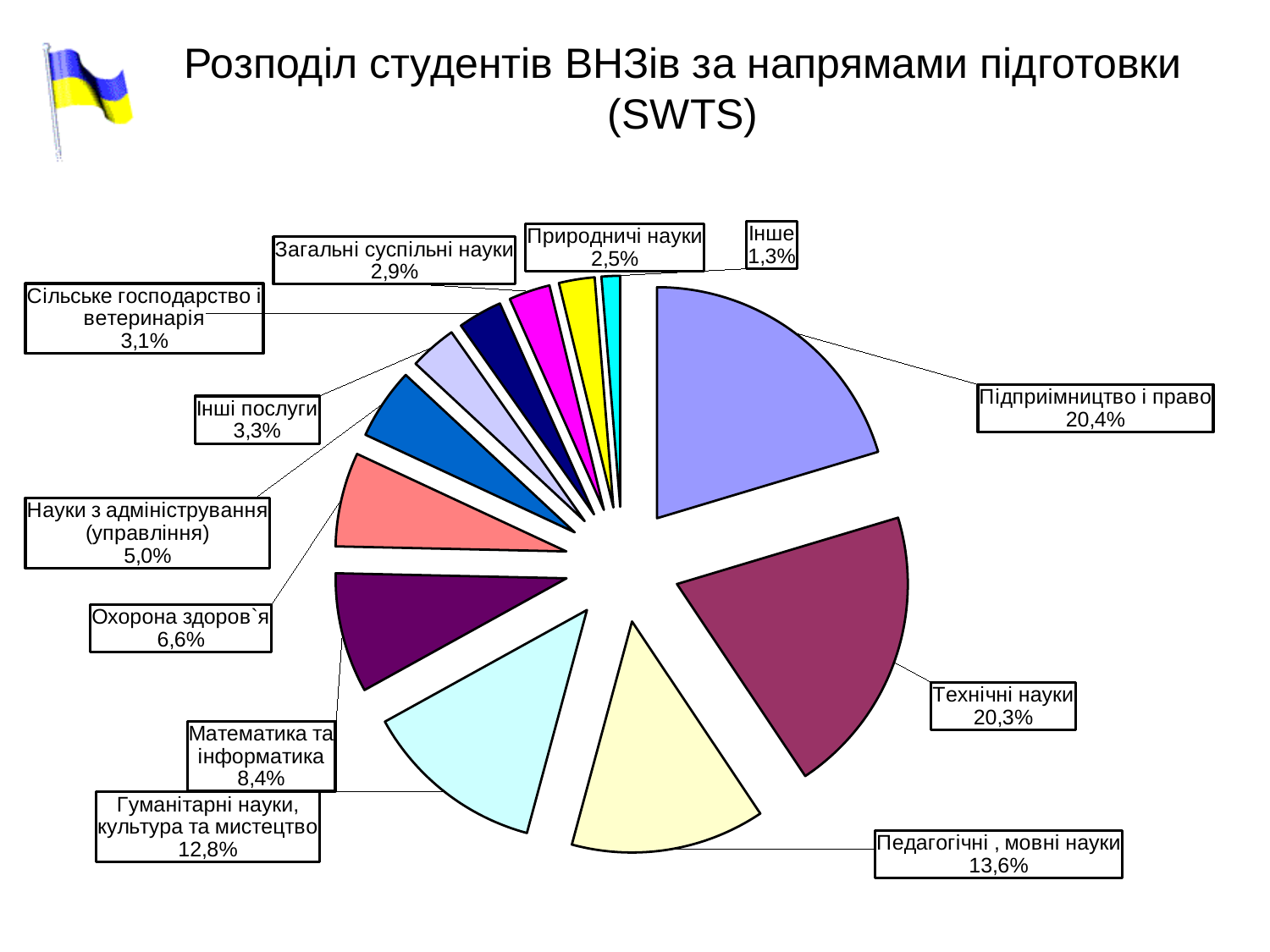
What share of students is in Гуманітарні науки, культура та мистецтво? 12,8% What is the difference in percentage points between Математика та інформатика and Охорона здоров`я? 1,8 What share of students is in Охорона здоров`я? 6,6% Which has a larger share: Педагогічні, мовні науки or Математика та інформатика? Педагогічні, мовні науки What share of students is in Підприємництво і право? 20,4% What share of students is in Технічні науки? 20,3% What is the title of the chart on the slide? Розподіл студентів ВНЗів за напрямами підготовки (SWTS) What is the combined share of Підприємництво і право and Технічні науки? 40,7% What is the difference in percentage points between Педагогічні, мовні науки and Гуманітарні науки, культура та мистецтво? 0,8 Which category has the smallest share of students? Інше What kind of chart is shown on the slide? pie chart How many slices does the pie chart have? 12